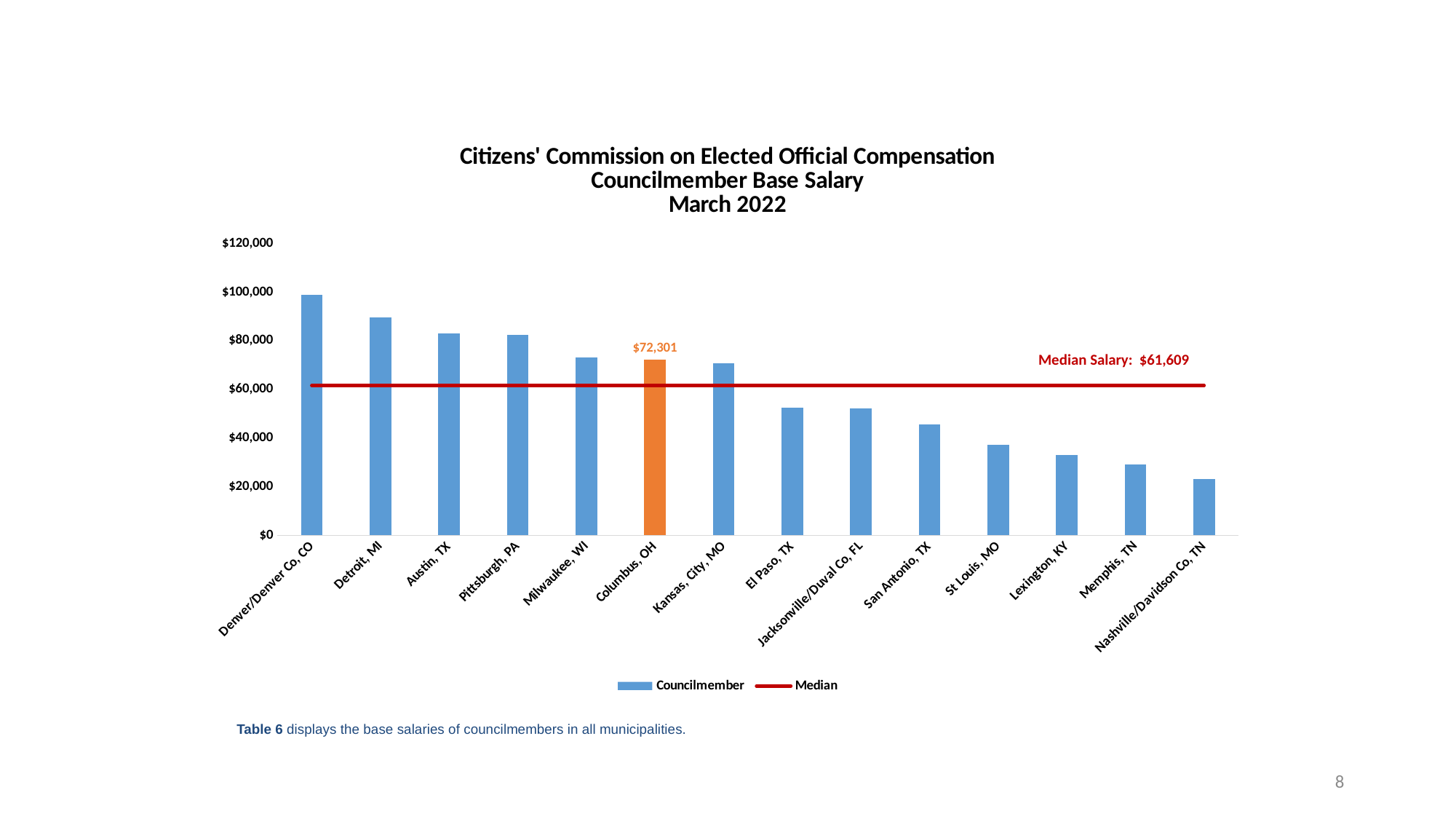
Do the councilmember base salaries rise or fall from left to right across the chart? Fall Which municipality has the highest councilmember base salary? Denver/Denver Co, CO What colour is the bar for Columbus, OH? Orange Is the value for Denver/Denver Co, CO greater or less than $80,000? greater Is the value for El Paso, TX greater or less than $60,000? less How many municipalities are shown on the chart? 14 Which municipality has the lowest councilmember base salary? Nashville/Davidson Co, TN Which has the larger councilmember base salary, Detroit, MI or Memphis, TN? Detroit, MI What kind of chart is used to show the councilmember base salaries? Bar chart What is the councilmember base salary shown for Columbus, OH? $72,301 What median salary is shown on the chart? $61,609 How many series does the legend list? 2